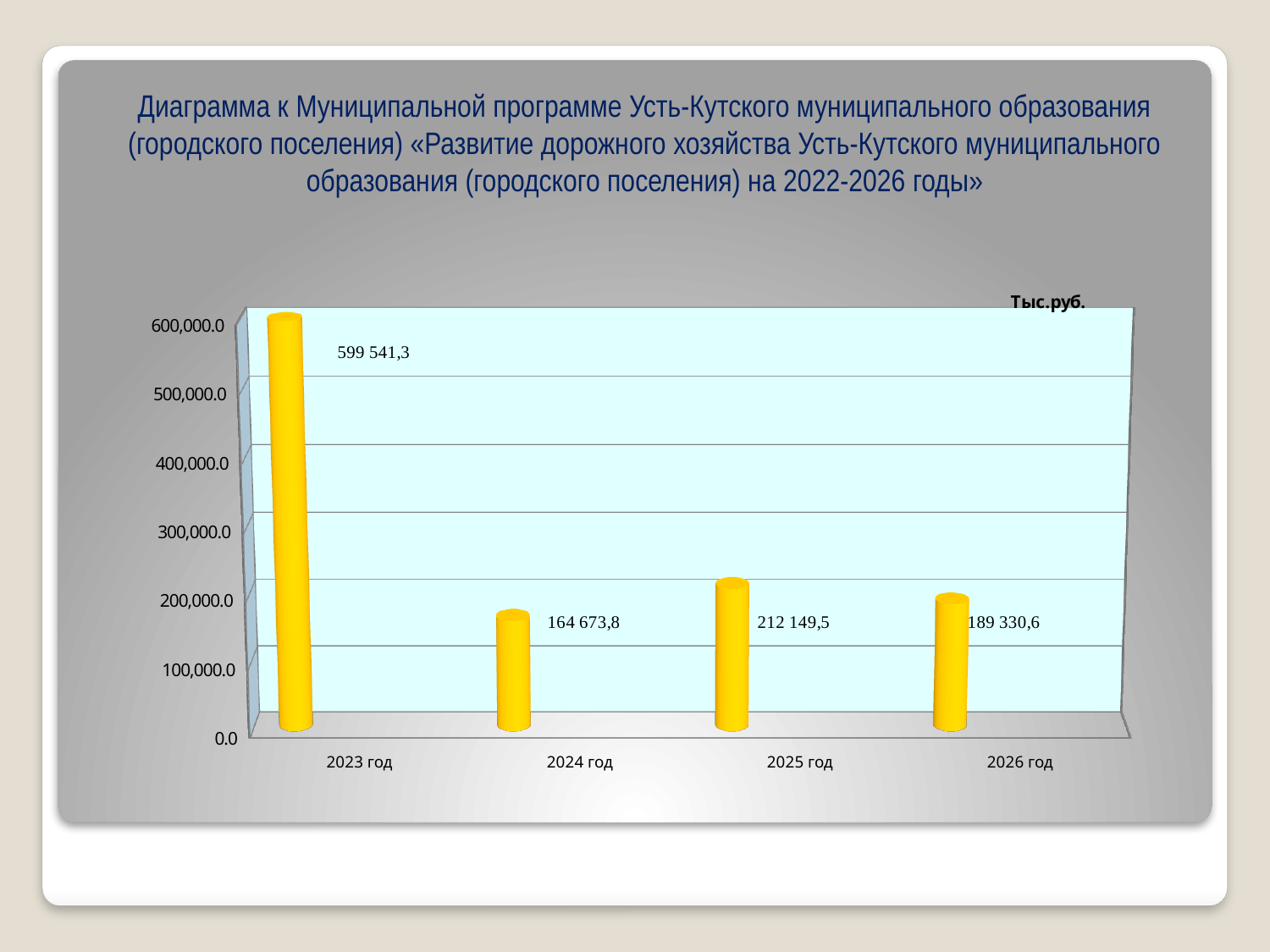
Which year has the lowest value? 2024 год Is the value for 2024 год greater or less than 200,000.0? less What kind of chart is shown on the slide? bar chart What is the value for 2024 год? 164 673,8 Which is larger, the value for 2025 год or the value for 2026 год? 2025 год What is the value for 2026 год? 189 330,6 What is the value for 2023 год? 599 541,3 What is the difference between the values for 2025 год and 2026 год? 22 818,9 What is the difference between the values for 2023 год and 2024 год? 434 867,5 Which year has the highest value? 2023 год How many years are shown on the x axis? 4 What is the value for 2025 год? 212 149,5